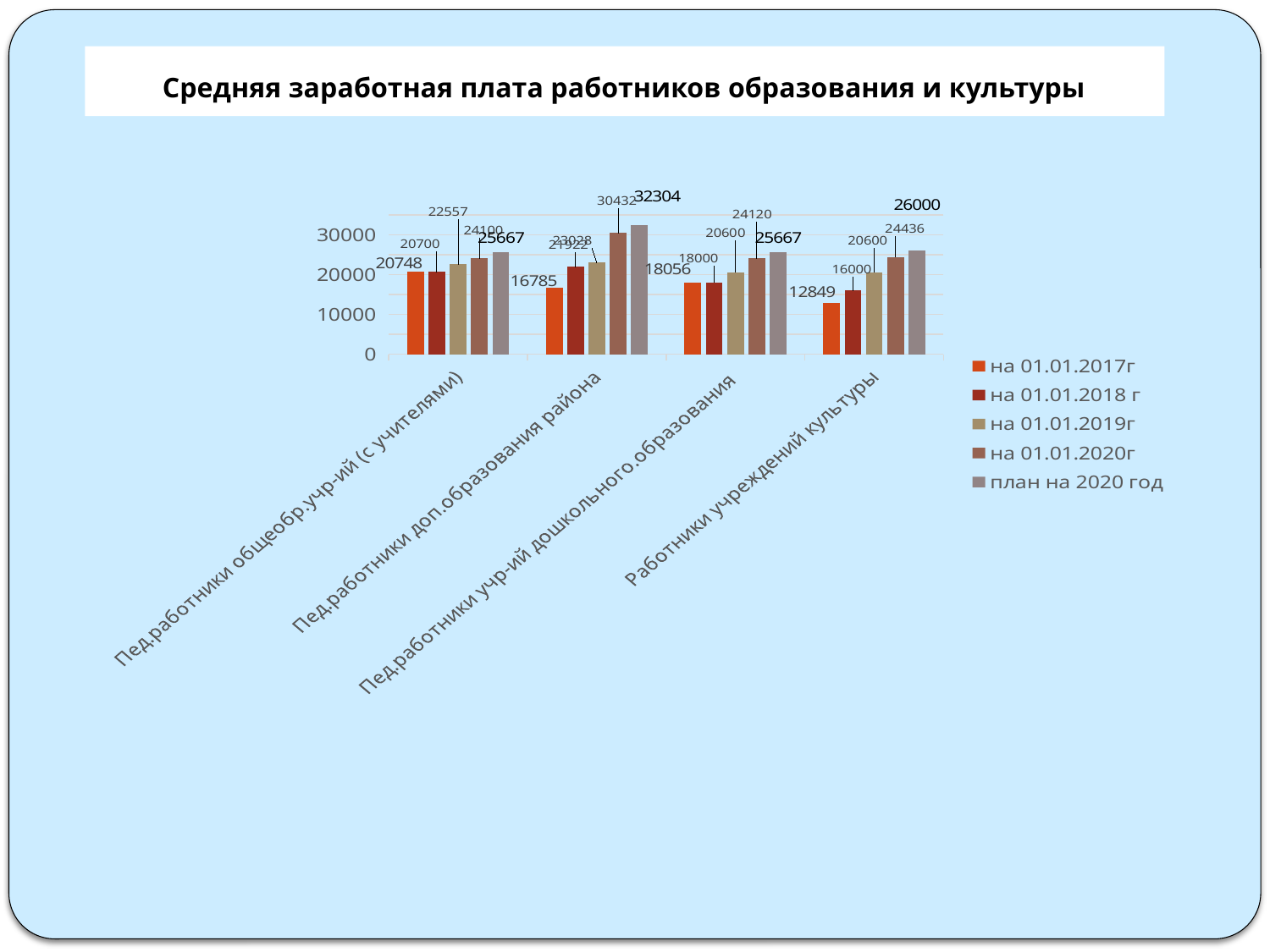
How many categories are shown on the x axis? 4 For Работники учреждений культуры, what is the difference between план на 2020 год and на 01.01.2017г? 13151 Is the value for Пед.работники доп.образования района in the series на 01.01.2020г greater or less than 30000? greater In the series на 01.01.2019г, which is larger: Пед.работники общеобр.учр-ий (с учителями) or Пед.работники учр-ий дошкольного.образования? Пед.работники общеобр.учр-ий (с учителями) What is the value for Пед.работники доп.образования района in the series план на 2020 год? 32304 What is the value for Работники учреждений культуры in the series на 01.01.2017г? 12849 What kind of chart is shown on the slide? bar chart What is the title of the chart? Средняя заработная плата работников образования и культуры Which category has the lowest value in the series на 01.01.2017г? Работники учреждений культуры What is the value for Пед.работники учр-ий дошкольного.образования in the series на 01.01.2020г? 24120 How many series does the legend list? 5 Which category has the highest value in the series план на 2020 год? Пед.работники доп.образования района